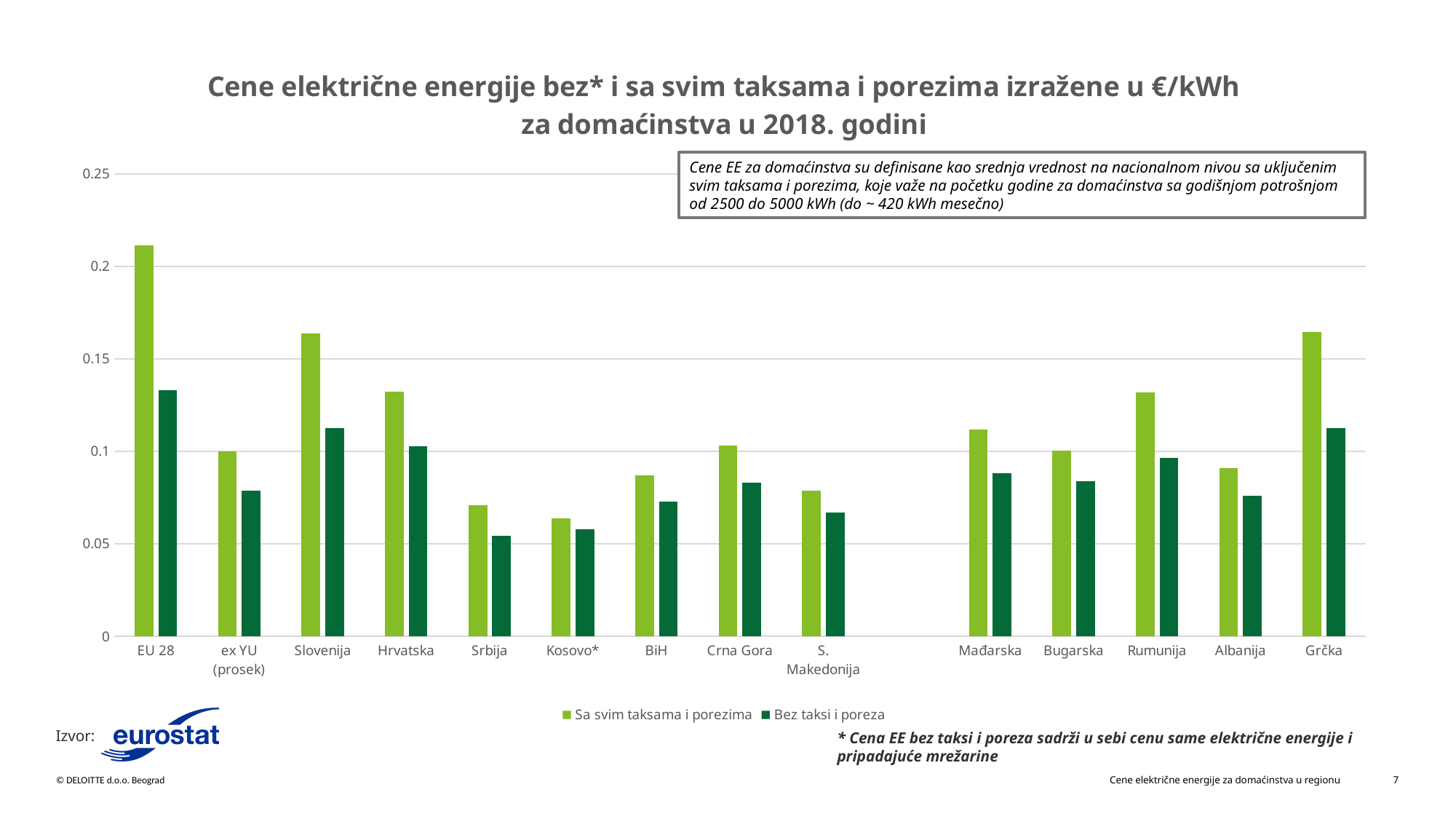
Which is larger for 'Bez taksi i poreza': Slovenija or Hrvatska? Slovenija Which category has the highest value for 'Bez taksi i poreza'? EU 28 Is the 'Sa svim taksama i porezima' value for Slovenija greater or less than 0.15? greater What is the source of the data cited on the slide? eurostat Which category has the highest value for 'Sa svim taksama i porezima'? EU 28 Which is larger for 'Sa svim taksama i porezima': Crna Gora or BiH? Crna Gora How many countries/categories are shown on the x axis? 14 Is the 'Bez taksi i poreza' value for Albanija greater or less than 0.1? less Is the 'Sa svim taksama i porezima' value for EU 28 greater or less than 0.2? greater How many series does the legend list? 2 Which category has the lowest value for 'Sa svim taksama i porezima'? Kosovo* What kind of chart is shown on the slide? bar chart